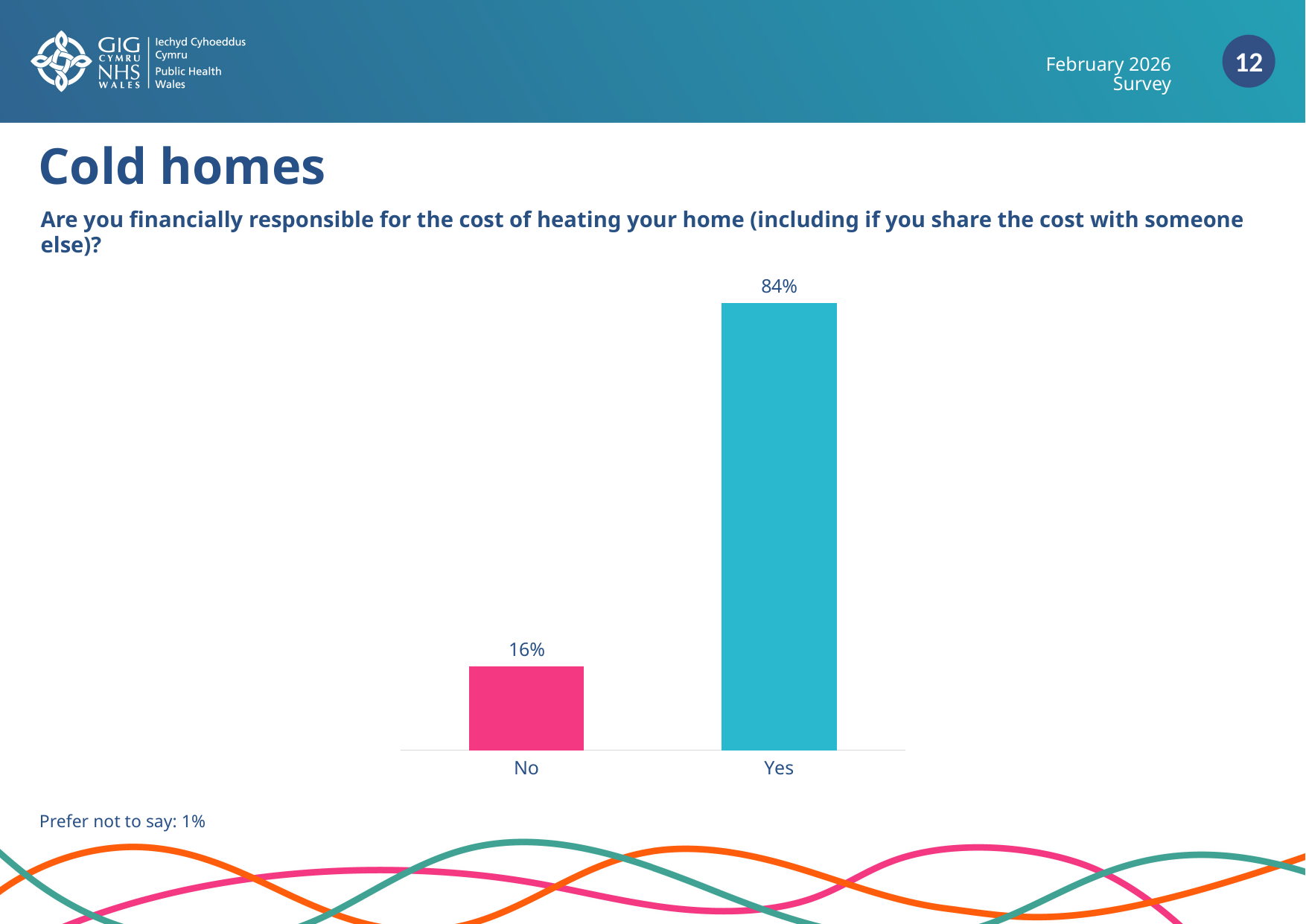
What colour is the bar for the "No" response? Pink Which is larger, the value for "Yes" or the value for "No"? Yes What percentage of respondents answered "No"? 16% What colour is the bar for the "Yes" response? Teal/blue What kind of chart is shown on the slide? Bar chart Which response category has the highest value? Yes What percentage of respondents preferred not to say, according to the note below the chart? 1% What is the combined percentage of the "Yes" and "No" responses shown in the chart? 100% Which response category has the lowest value? No How many response categories are plotted in the chart? 2 What percentage of respondents answered "Yes" to being financially responsible for the cost of heating their home? 84% What is the difference in percentage points between the "Yes" and "No" responses? 68 percentage points